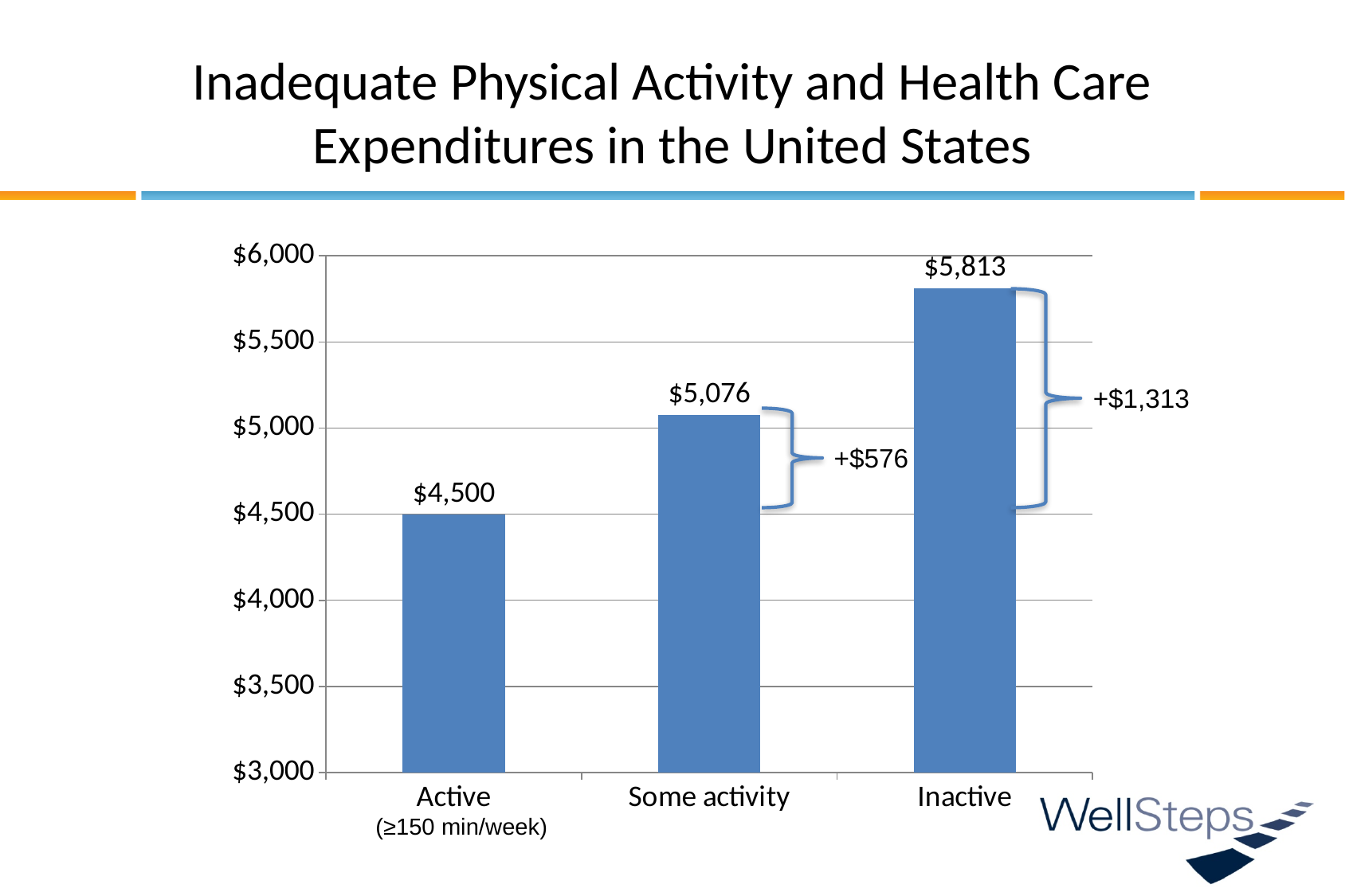
What is the value for the Some activity category? $5,076 Which category has the lowest value? Active What is the difference between the Some activity and Active values? $576 What kind of chart is shown on the slide? Bar chart Do the values rise or fall from Active to Inactive along the x axis? Rise How many categories are shown on the chart? 3 Is the value for Some activity greater or less than $5,000? greater Which category has the highest value? Inactive What is the difference between the Inactive and Active values? $1,313 What is the value for the Active category? $4,500 Which is larger, the value for Some activity or the value for Inactive? Inactive What is the value for the Inactive category? $5,813